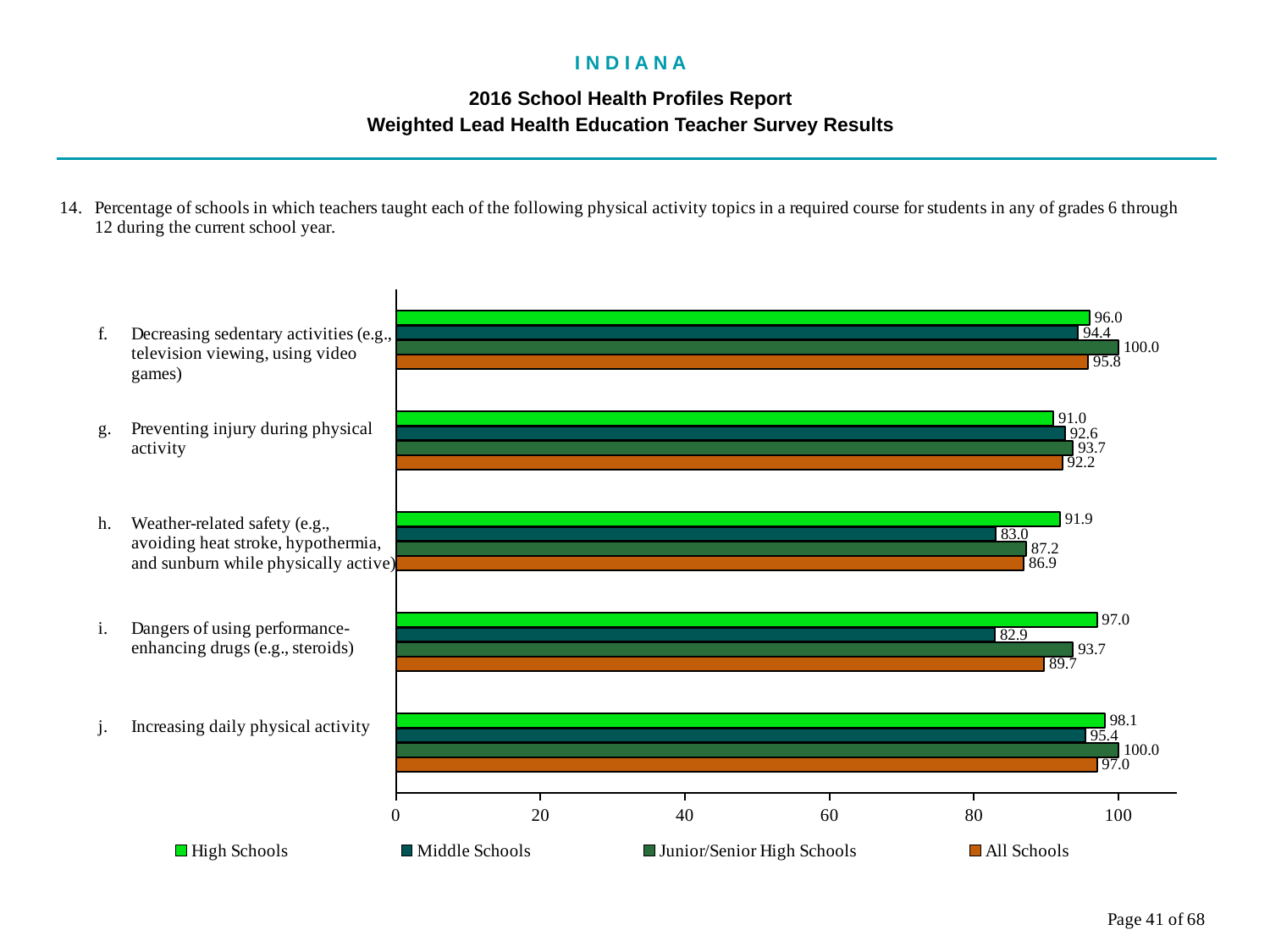
What is the value for Junior/Senior High Schools for 'Preventing injury during physical activity'? 93.7 How many physical activity topics are shown on the chart? 5 For 'Weather-related safety', which is larger: the High Schools value or the Middle Schools value? High Schools What kind of chart is shown on the slide? Bar chart How many series does the legend list? 4 What is the difference between the High Schools and Middle Schools values for 'Dangers of using performance-enhancing drugs (e.g., steroids)'? 14.1 What is the value for All Schools for 'Weather-related safety (e.g., avoiding heat stroke, hypothermia, and sunburn while physically active)'? 86.9 What is the value for High Schools for 'Increasing daily physical activity'? 98.1 Which topic has the highest value for High Schools? Increasing daily physical activity What is the value for Middle Schools for 'Dangers of using performance-enhancing drugs (e.g., steroids)'? 82.9 Which topic has the lowest value for Middle Schools? Dangers of using performance-enhancing drugs (e.g., steroids) Is the All Schools value for 'Dangers of using performance-enhancing drugs (e.g., steroids)' greater or less than 80? greater